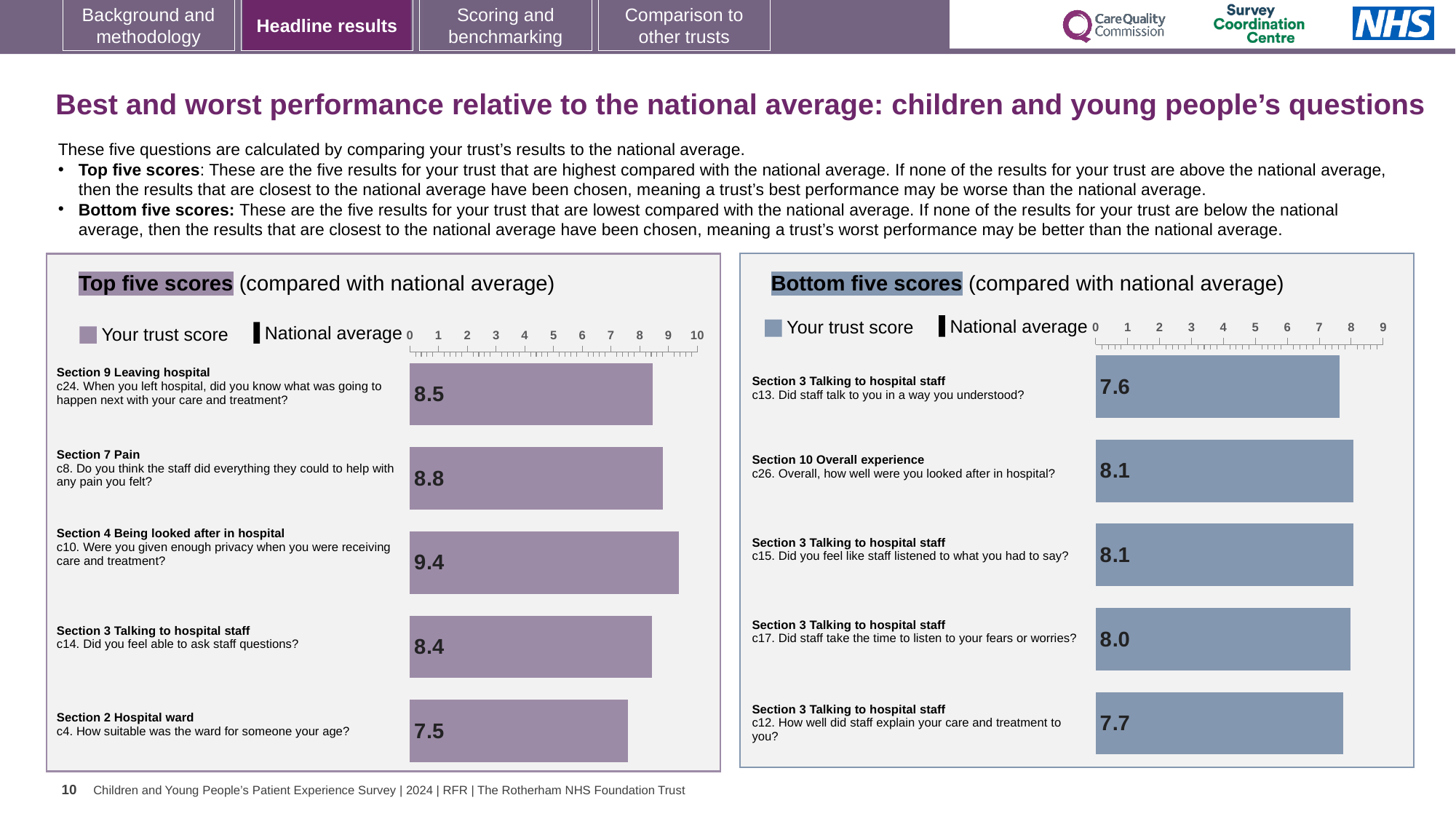
In the Top five scores chart, which question has the lowest trust score? c4. How suitable was the ward for someone your age? In the Bottom five scores chart, what is the difference between the trust scores for c15 and c12? 0.4 In the Bottom five scores chart, which has the larger trust score: c26 'Overall, how well were you looked after in hospital?' or c17 'Did staff take the time to listen to your fears or worries?' c26. Overall, how well were you looked after in hospital? In the Top five scores chart, what is the difference between the trust scores for c8 (pain) and c4 (ward suitability)? 1.3 In the Top five scores chart, which question has the highest trust score? c10. Were you given enough privacy when you were receiving care and treatment? How many questions are plotted in the Top five scores chart? 5 What type of chart is the Bottom five scores chart? Bar chart What two entries does the legend of the Top five scores chart list? Your trust score; National average In the Top five scores chart, what is the trust score for c14 'Did you feel able to ask staff questions?' 8.4 In the Bottom five scores chart, what is the trust score for c13 'Did staff talk to you in a way you understood?' 7.6 In the Top five scores chart, what is the trust score for c10 'Were you given enough privacy when you were receiving care and treatment?' 9.4 In the Bottom five scores chart, which question has the lowest trust score? c13. Did staff talk to you in a way you understood?